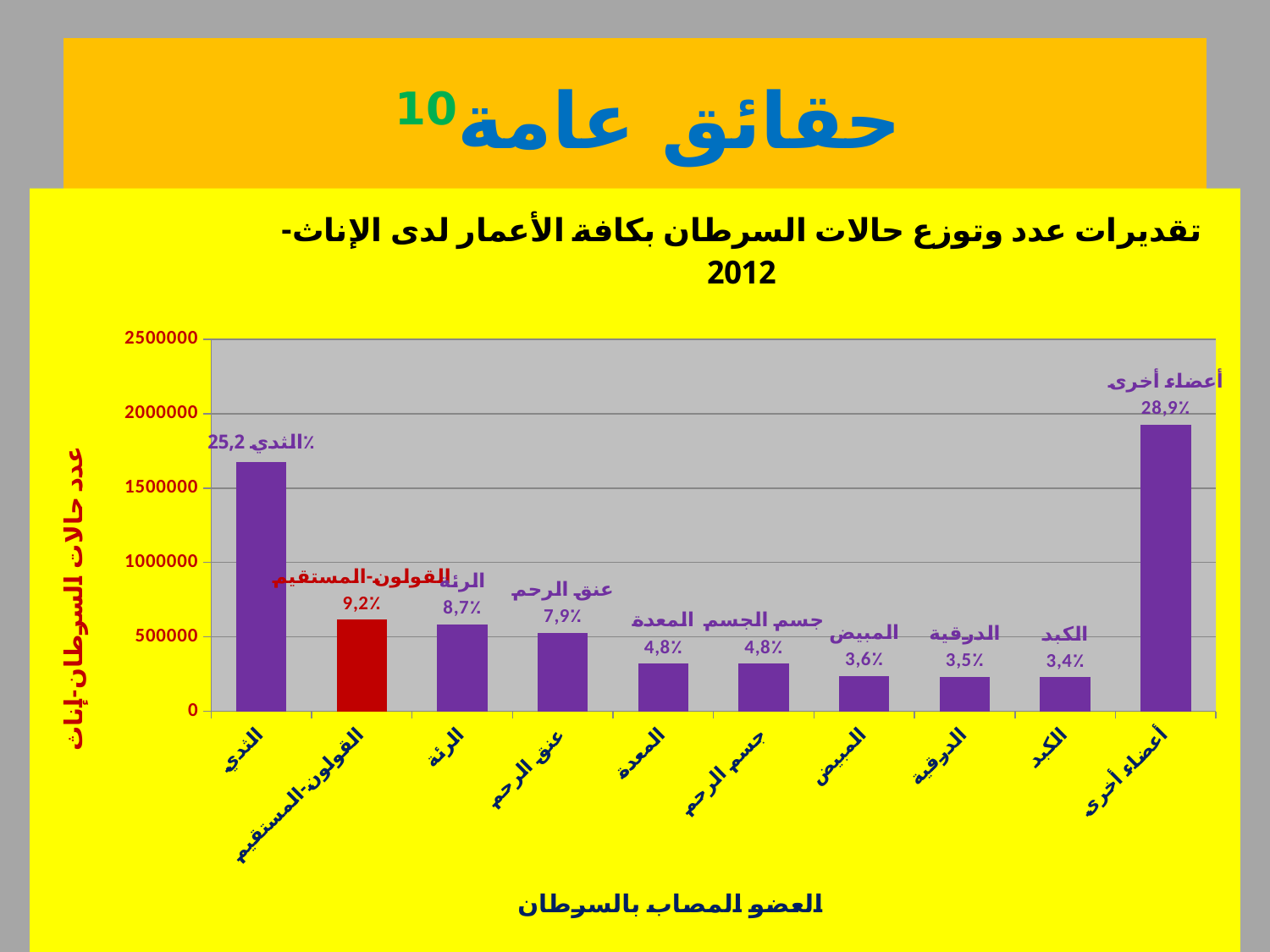
What percentage label is shown for الثدي (breast)? 25,2% Is the value for الثدي greater or less than 1500000? greater How many categories are shown on the x axis? 10 What kind of chart is shown on the slide? bar chart Is the value for المعدة greater or less than 500000? less What is the difference between the percentage labels for الرئة and عنق الرحم? 0,8% Which category has the lowest percentage label? الكبد What percentage label is shown for الكبد (liver)? 3,4% Which bar is coloured red instead of purple? القولون-المستقيم What percentage label is shown for القولون-المستقيم (colorectal)? 9,2% Which category has the tallest bar? أعضاء أخرى Which has a larger percentage label, المبيض or الدرقية? المبيض